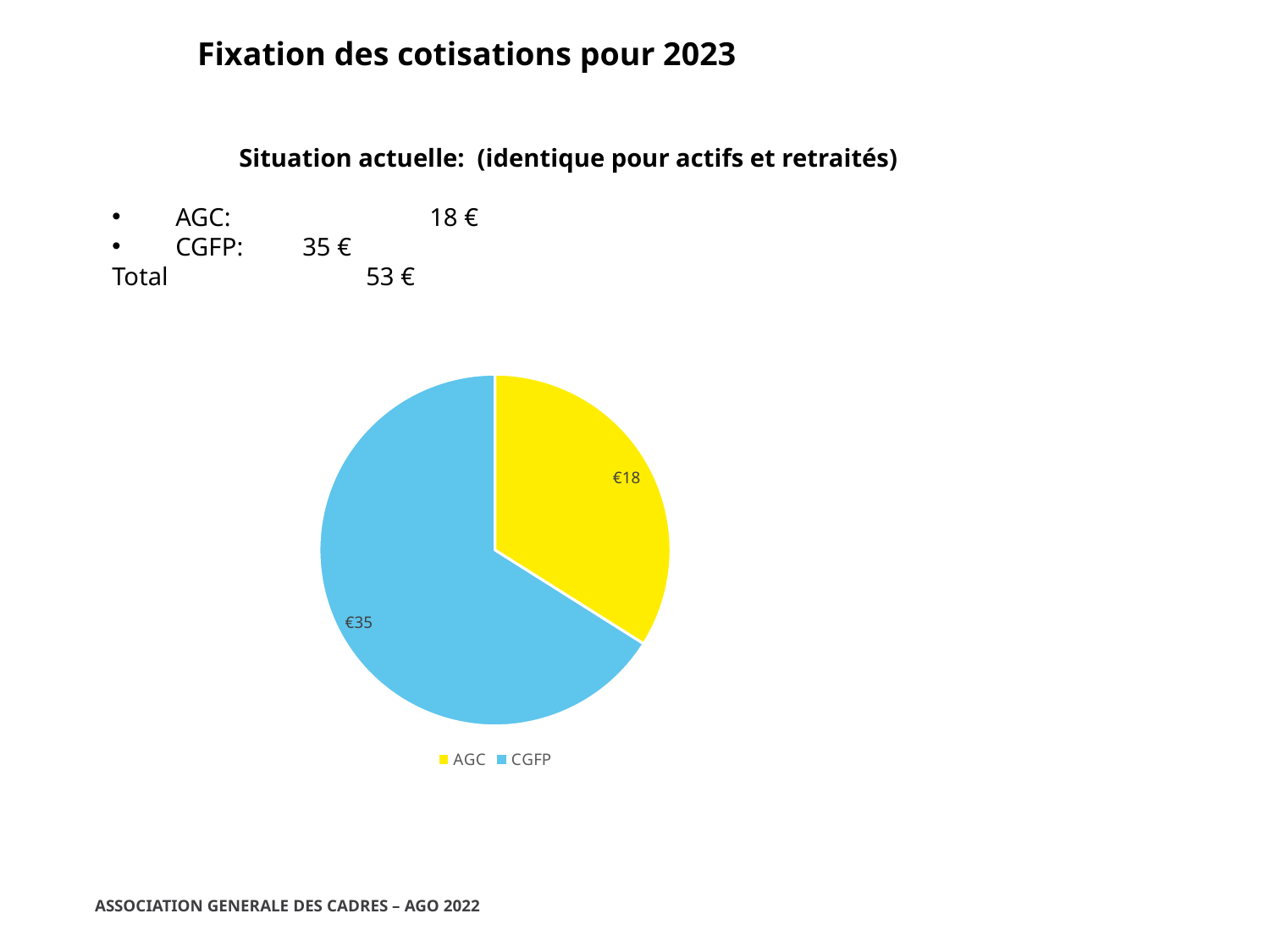
What is the total of the two slices in the pie chart? €53 What colour is the AGC slice in the pie chart? yellow What colour is the CGFP slice in the pie chart? blue What is the difference between the CGFP and AGC values in the pie chart? €17 What kind of chart is shown on the slide? pie chart How many entries does the pie chart legend list? 2 What is the value of the CGFP slice in the pie chart? €35 Which is larger in the pie chart, AGC or CGFP? CGFP How many slices does the pie chart have? 2 What is the value of the AGC slice in the pie chart? €18 Which slice of the pie chart is the largest? CGFP Which slice of the pie chart is the smallest? AGC